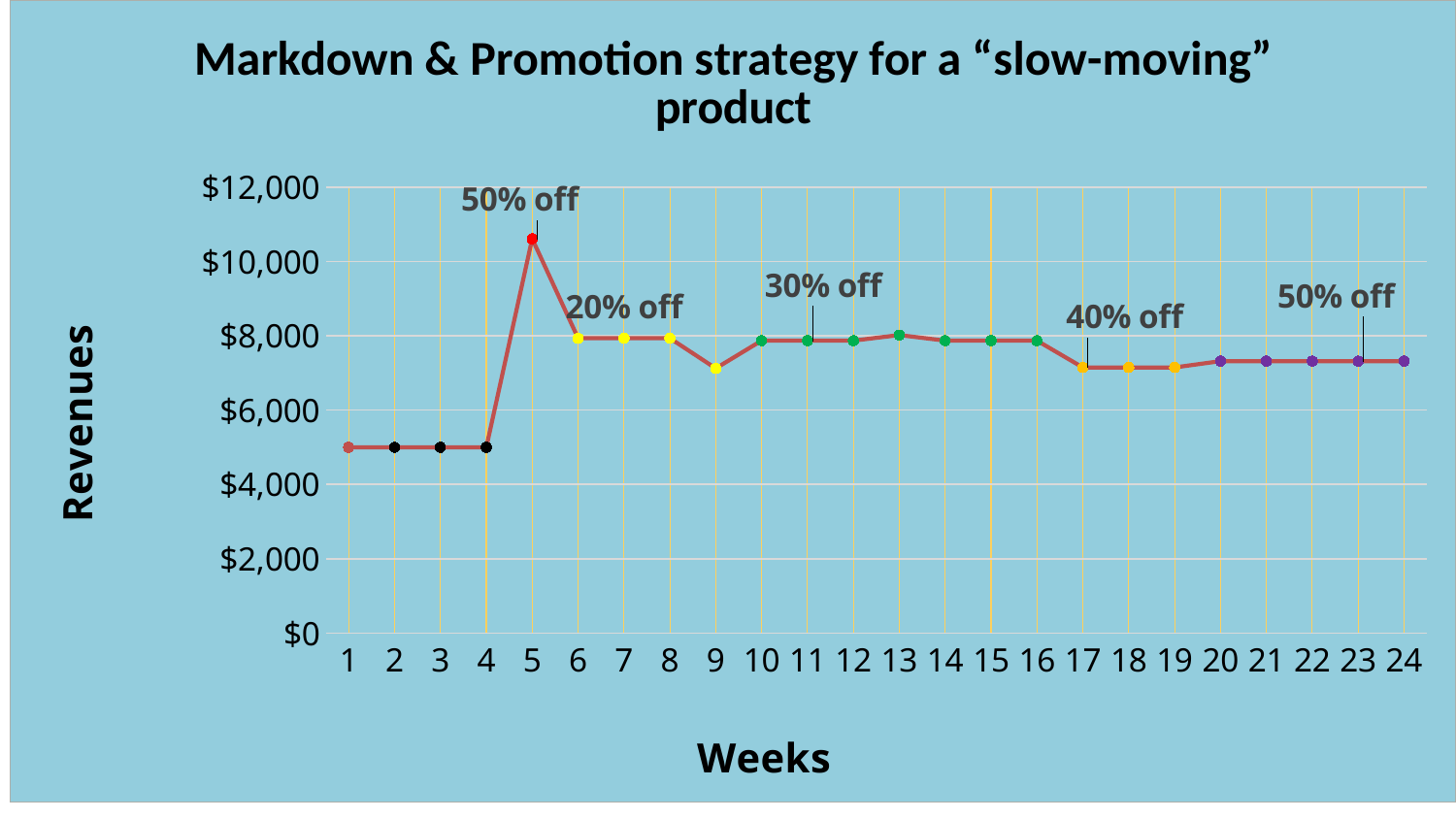
What kind of chart is shown on the slide? line chart Which has the higher revenue, week 5 or week 10? Week 5 What is the label of the y axis? Revenues Is the revenue for week 1 greater or less than $6,000? less How many weeks are plotted on the x axis? 24 Is the revenue for week 20 greater or less than $8,000? less What discount is annotated at week 17? 40% off Which week has the highest revenue? Week 5 Is the revenue for week 9 greater or less than $8,000? less Which has the higher revenue, week 4 or week 17? Week 17 Do revenues rise or fall from week 5 to week 9? fall